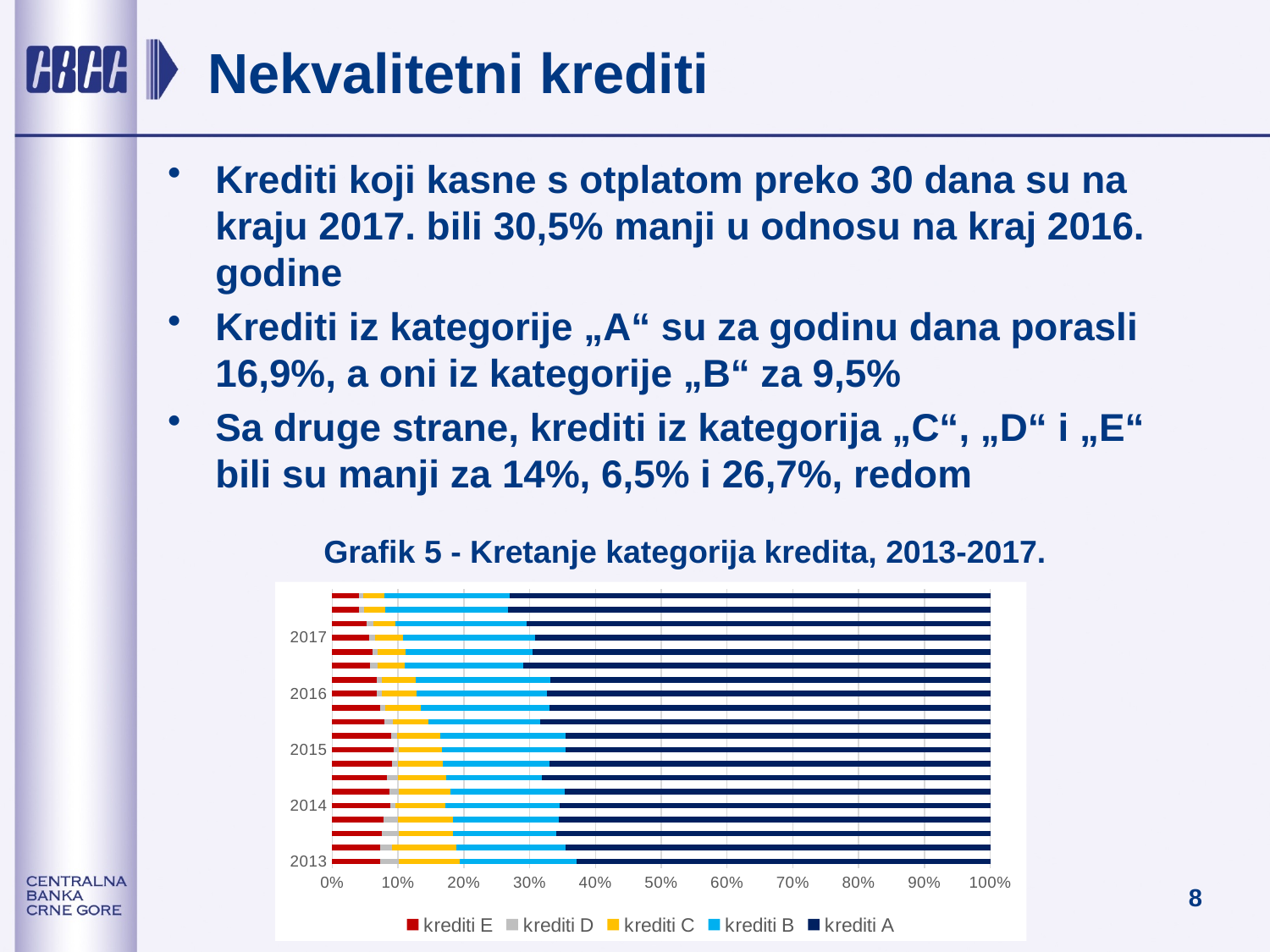
How many series does the chart legend list? 5 How many year labels appear on the vertical axis of the chart? 5 Is the combined share of krediti E, D, C and B in the 2013 bars greater or less than 50%? less Which series is shown in dark blue in the chart? krediti A What kind of chart is shown on the slide? Stacked bar chart Does the share of krediti A rise or fall from 2013 to 2017? rise Which is larger in the 2013 bars, the share of krediti A or the share of krediti B? krediti A What is the title of the chart on the slide? Grafik 5 - Kretanje kategorija kredita, 2013-2017. Does the share of krediti C rise or fall from 2013 to 2017? fall Is the share of krediti A in the 2017 bars greater or less than 50%? greater Which series occupies the largest share of each bar in the chart? krediti A Is the share of krediti E in the 2013 bars greater or less than 10%? less